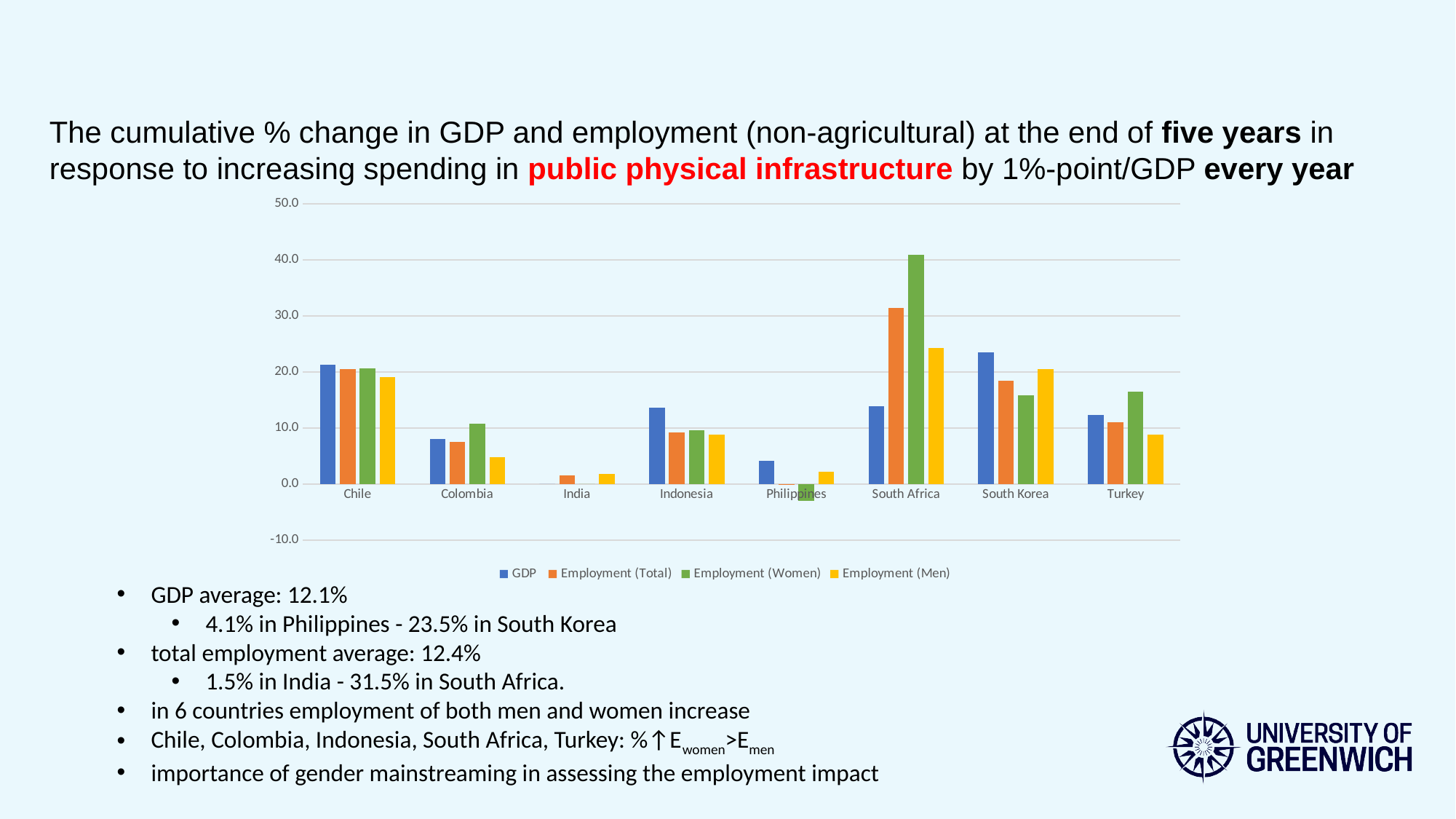
For South Korea, which is larger: GDP or Employment (Women)? GDP Which country has the highest Employment (Total) value? South Africa Is the Employment (Men) value for Colombia greater or less than 10? less Is the Employment (Women) value for South Africa greater or less than 30? greater For Turkey, which is larger: Employment (Women) or Employment (Men)? Employment (Women) Is the Employment (Total) value for South Africa greater or less than 20? greater Which country has the lowest Employment (Women) value? Philippines Which country has the highest Employment (Women) value? South Africa What kind of chart is shown on the slide? bar chart What colour represents Employment (Men) in the legend? yellow How many series does the legend list? 4 How many countries are shown on the x axis? 8